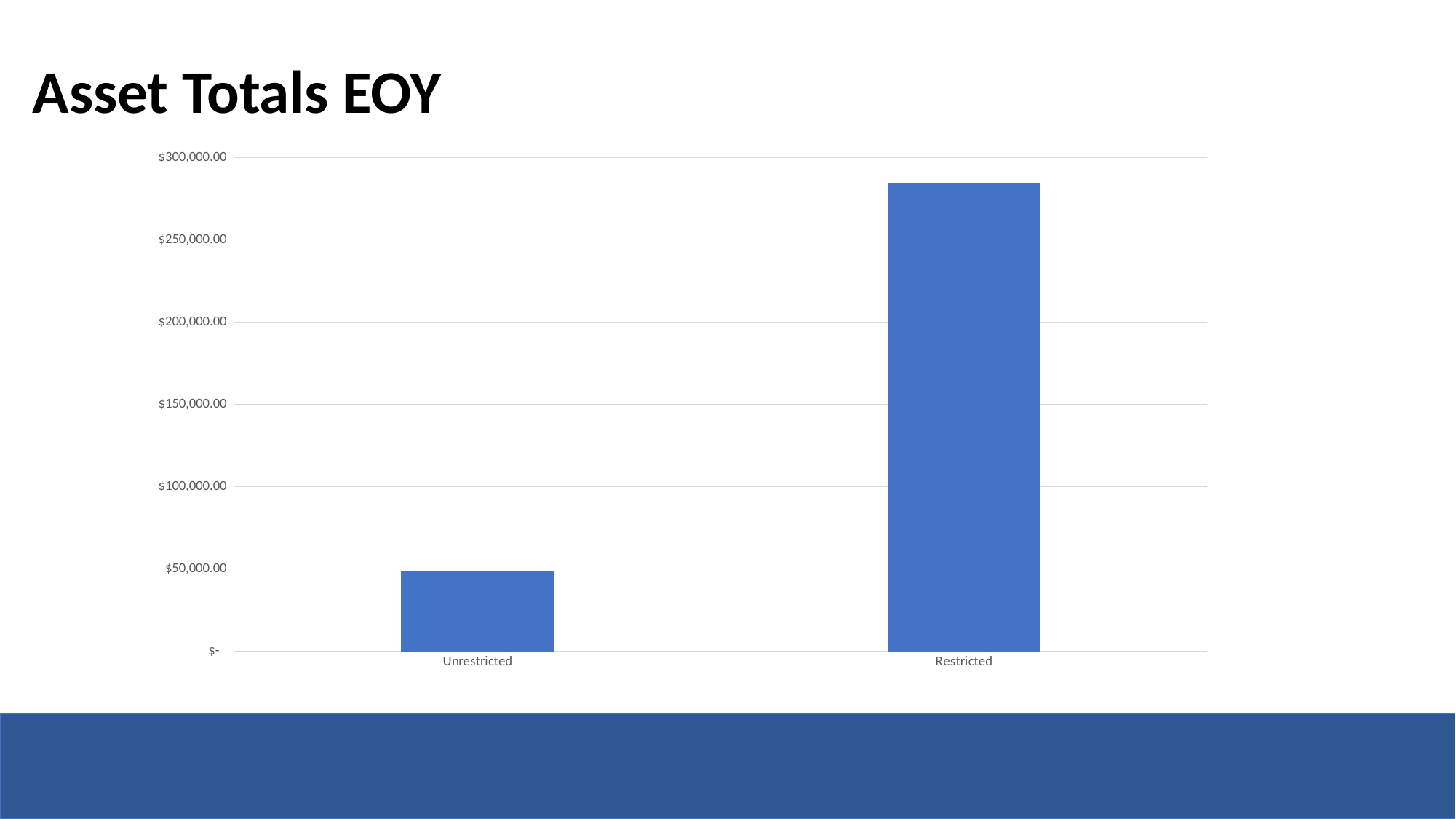
Which is larger, the value for Unrestricted or the value for Restricted? Restricted What kind of chart is shown on the slide? bar chart Is the value for Restricted greater or less than $300,000.00? less Which category has the highest value? Restricted Is the value for Unrestricted greater or less than $100,000.00? less Which category has the lowest value? Unrestricted How many categories are plotted in the chart? 2 What is the highest value shown on the vertical axis? $300,000.00 Is the value for Restricted greater or less than $250,000.00? greater What is the title of the slide containing the chart? Asset Totals EOY